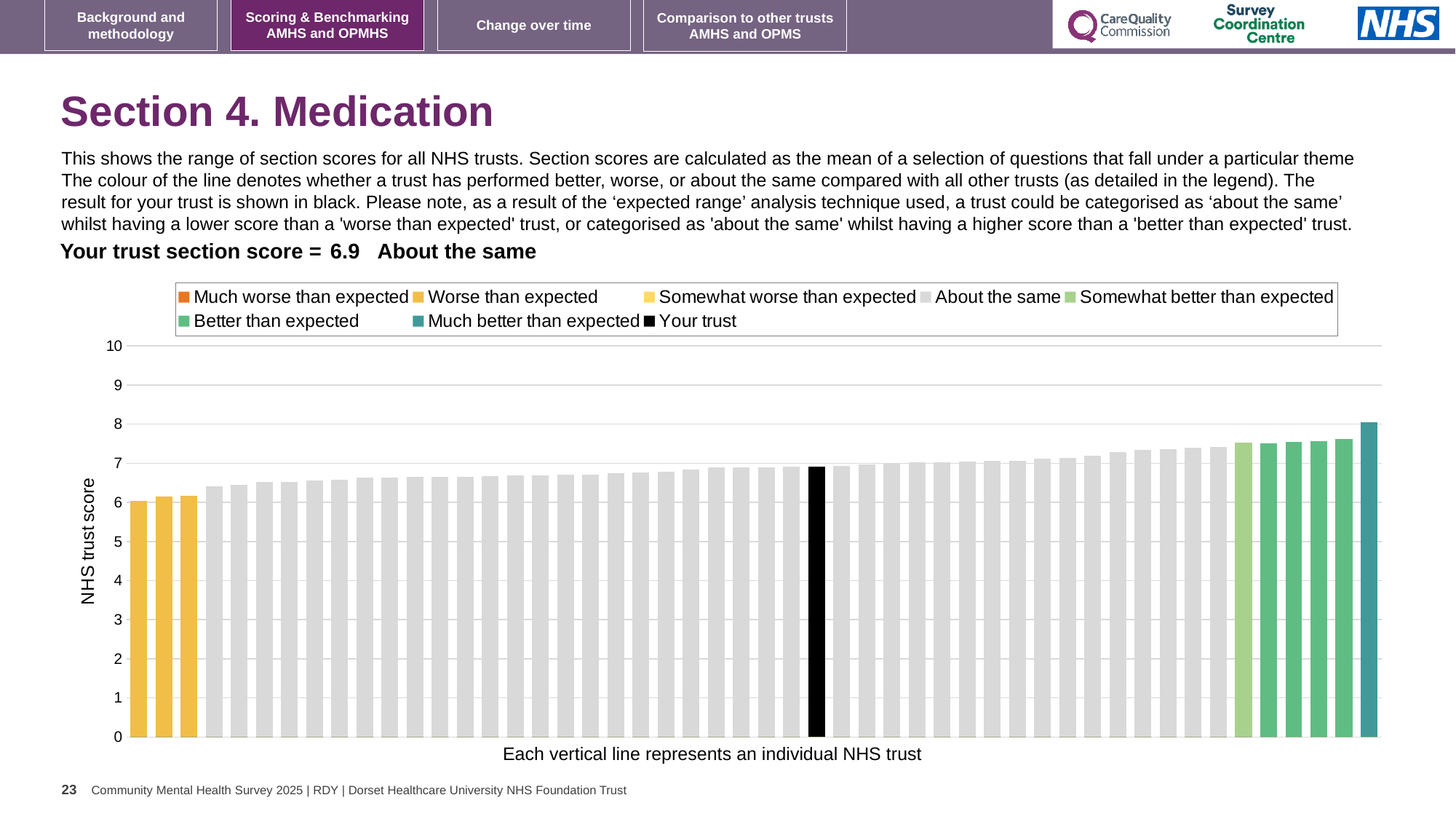
Which legend category does the tallest bar in the chart belong to? Much better than expected How many entries does the chart legend list? 8 Is the value of the lowest bar in the chart greater or less than 7? less How many bars are coloured as 'Worse than expected'? 3 Which legend category do the shortest bars in the chart belong to? Worse than expected Which category is your trust placed in for this section? About the same Do the bar values rise or fall from left to right along the x axis? rise What colour is the bar representing your trust? black What is the section score for your trust shown on the slide? 6.9 What is the label on the vertical axis of the chart? NHS trust score What kind of chart is shown on the slide? bar chart Is the value of the black 'Your trust' bar greater or less than 5? greater